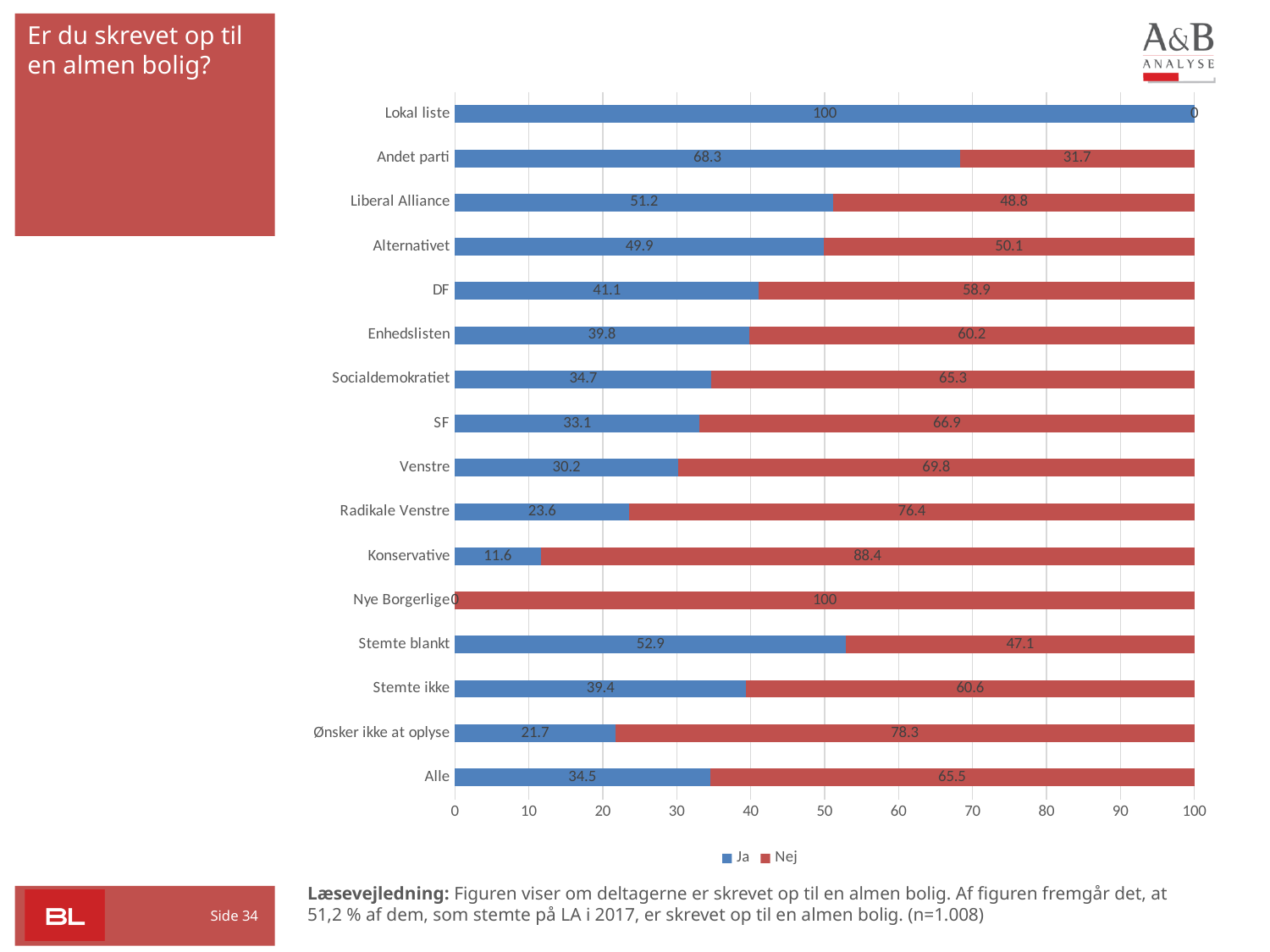
Which category has the lowest "Ja" value? Nye Borgerlige What is the total of the stacked bar for Stemte blankt? 100 Which has a larger "Ja" value, DF or Enhedslisten? DF Which category has the highest "Ja" value? Lokal liste What kind of chart is shown on the slide? Stacked bar chart What is the "Nej" value for Konservative? 88.4 How many categories are shown on the y axis? 16 What is the "Ja" value for Alle? 34.5 What is the "Ja" value for Liberal Alliance? 51.2 What is the difference between the "Nej" values for Venstre and SF? 2.9 How many series does the legend list? 2 What are the two series named in the legend? Ja and Nej